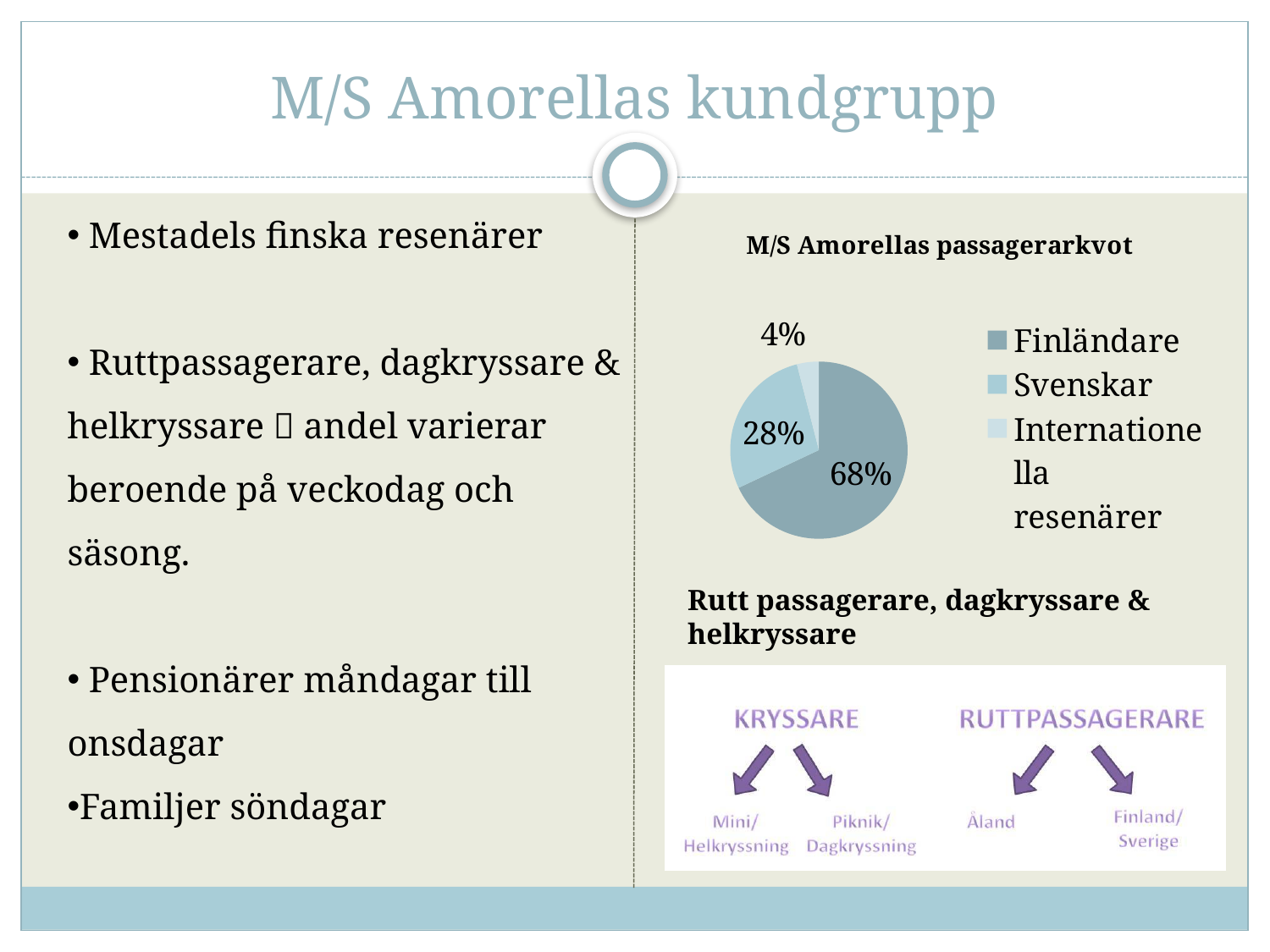
What is the title of the pie chart on the slide? M/S Amorellas passagerarkvot What share of the pie chart is Svenskar? 28% What is the difference in percentage points between the Finländare and Svenskar slices? 40 What share of the pie chart is Internationella resenärer? 4% Which slice is larger in the pie chart, Svenskar or Internationella resenärer? Svenskar How many slices does the pie chart have? 3 How many entries does the pie chart's legend list? 3 What share of the pie chart is Finländare? 68% What type of chart is shown under the title "M/S Amorellas passagerarkvot"? pie chart Which category has the smallest slice in the pie chart? Internationella resenärer What is the difference in percentage points between the Svenskar and Internationella resenärer slices? 24 Which category has the largest slice in the pie chart? Finländare